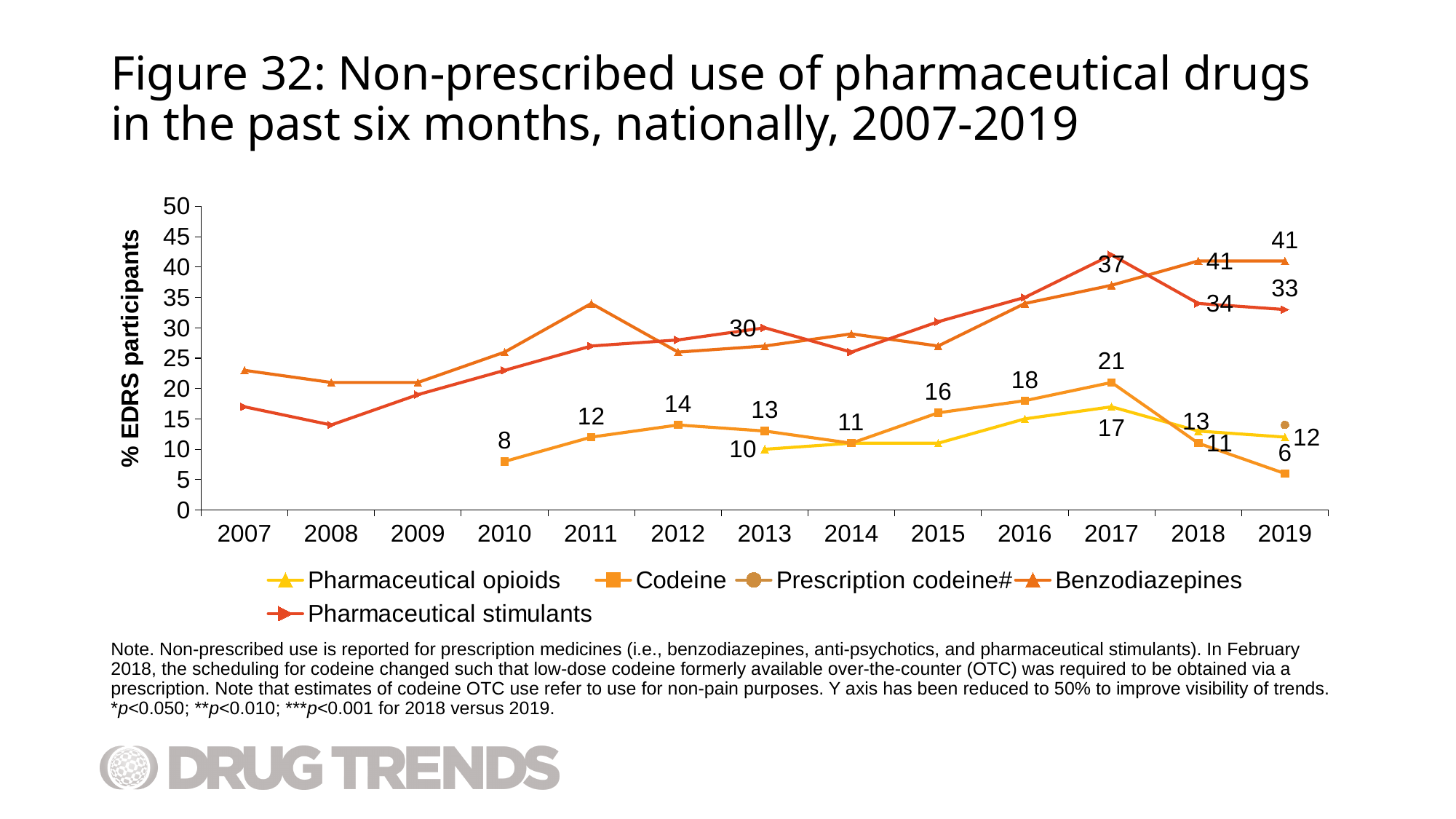
Is the value for Benzodiazepines in 2011 greater or less than 30? greater What was the value for Codeine in 2017? 21 What was the value for Benzodiazepines in 2019? 41 What was the value for Pharmaceutical opioids in 2013? 10 By how much did the Codeine value fall from 2018 to 2019? 5 In which year was the Codeine value highest? 2017 In which year was the Codeine value lowest? 2019 How many series does the legend list? 5 What kind of chart is shown on the slide? Line chart In 2019, which was higher: Benzodiazepines or Pharmaceutical stimulants? Benzodiazepines How many years are shown on the x axis? 13